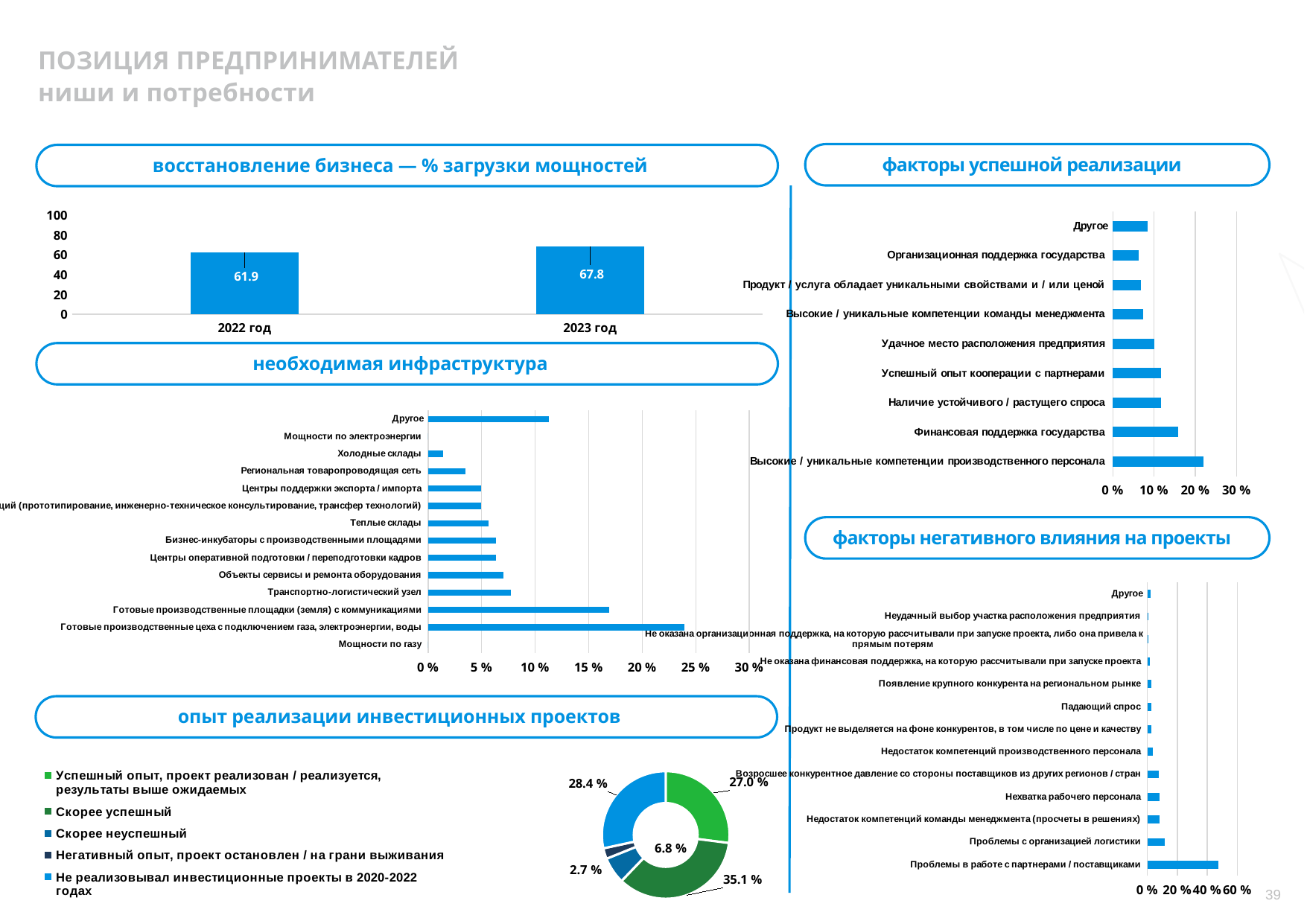
In the chart 'восстановление бизнеса — % загрузки мощностей', do the values rise or fall from 2022 год to 2023 год? rise In the chart 'необходимая инфраструктура', which category has the highest value? Готовые производственные цеха с подключением газа, электроэнергии, воды In the chart 'опыт реализации инвестиционных проектов', what share does 'Скорее успешный' have? 35.1 % In the chart 'восстановление бизнеса — % загрузки мощностей', what is the difference between the 2023 год and 2022 год values? 5.9 In the chart 'опыт реализации инвестиционных проектов', which category has the smallest share? Негативный опыт, проект остановлен / на грани выживания In the chart 'факторы успешной реализации', which category has the highest value? Высокие / уникальные компетенции производственного персонала In the chart 'необходимая инфраструктура', is the value for 'Готовые производственные цеха с подключением газа, электроэнергии, воды' greater or less than 20 %? greater How many entries does the legend of the chart 'опыт реализации инвестиционных проектов' list? 5 What kind of chart is 'опыт реализации инвестиционных проектов'? doughnut (pie) chart In the chart 'факторы негативного влияния на проекты', is the value for 'Проблемы в работе с партнерами / поставщиками' greater or less than 40 %? greater In the chart 'восстановление бизнеса — % загрузки мощностей', what is the value for 2023 год? 67.8 In the chart 'восстановление бизнеса — % загрузки мощностей', what is the value for 2022 год? 61.9